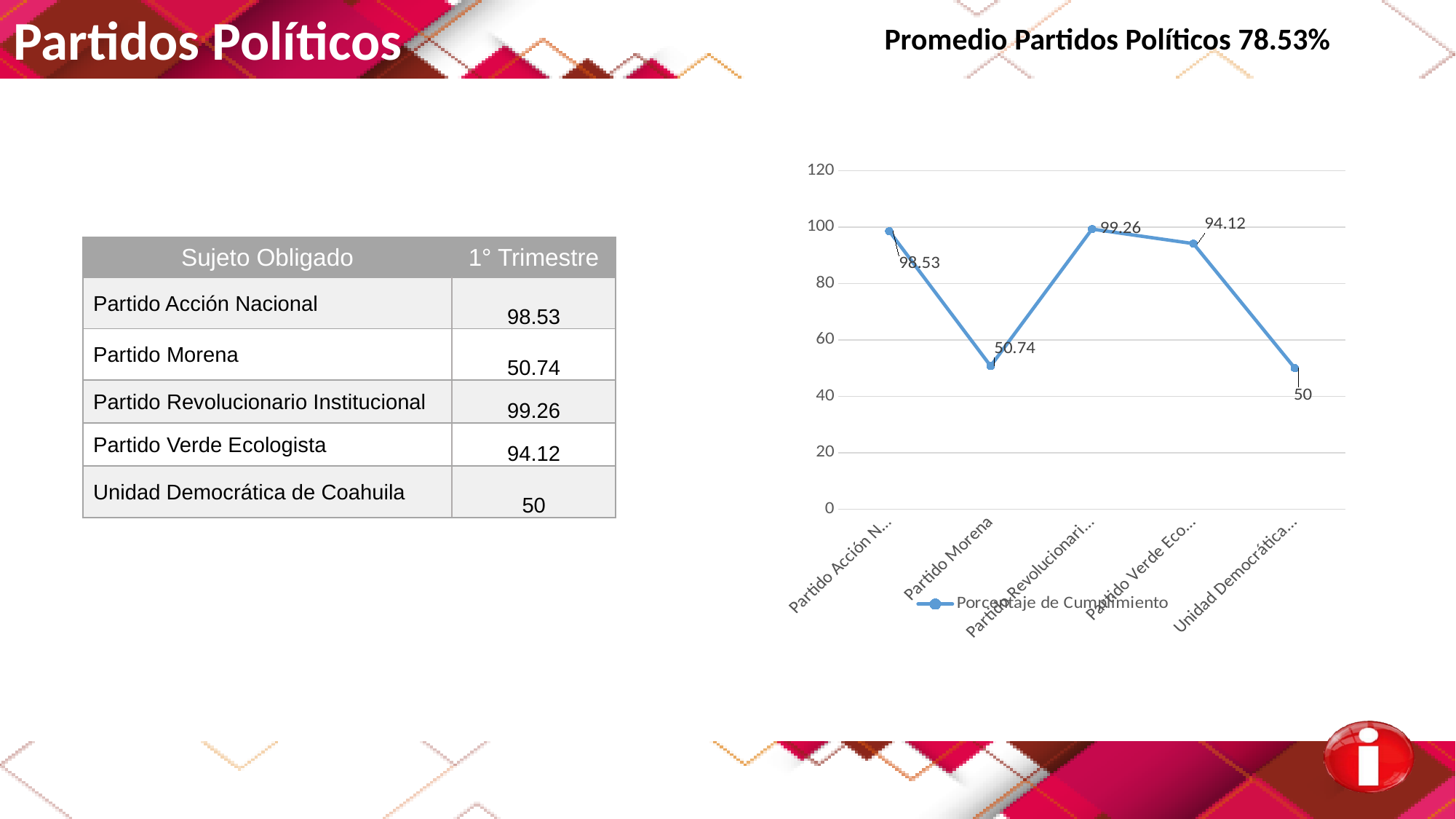
Which is larger, the value for Partido Verde Ecologista or the value for Partido Acción Nacional? Partido Acción Nacional What kind of chart is shown on the slide? line chart How many series does the chart legend list? 1 What is the value for Partido Verde Ecologista in the chart? 94.12 Which category has the lowest value in the chart? Unidad Democrática de Coahuila Is the value for Partido Morena greater or less than 60? less What is the value for Partido Morena in the chart? 50.74 Which category has the highest value in the chart? Partido Revolucionario Institucional What is the difference between the values for Partido Acción Nacional and Partido Morena? 47.79 What is the name of the series shown in the chart legend? Porcentaje de Cumplimiento What is the value for Unidad Democrática de Coahuila in the chart? 50 How many categories are plotted in the chart? 5